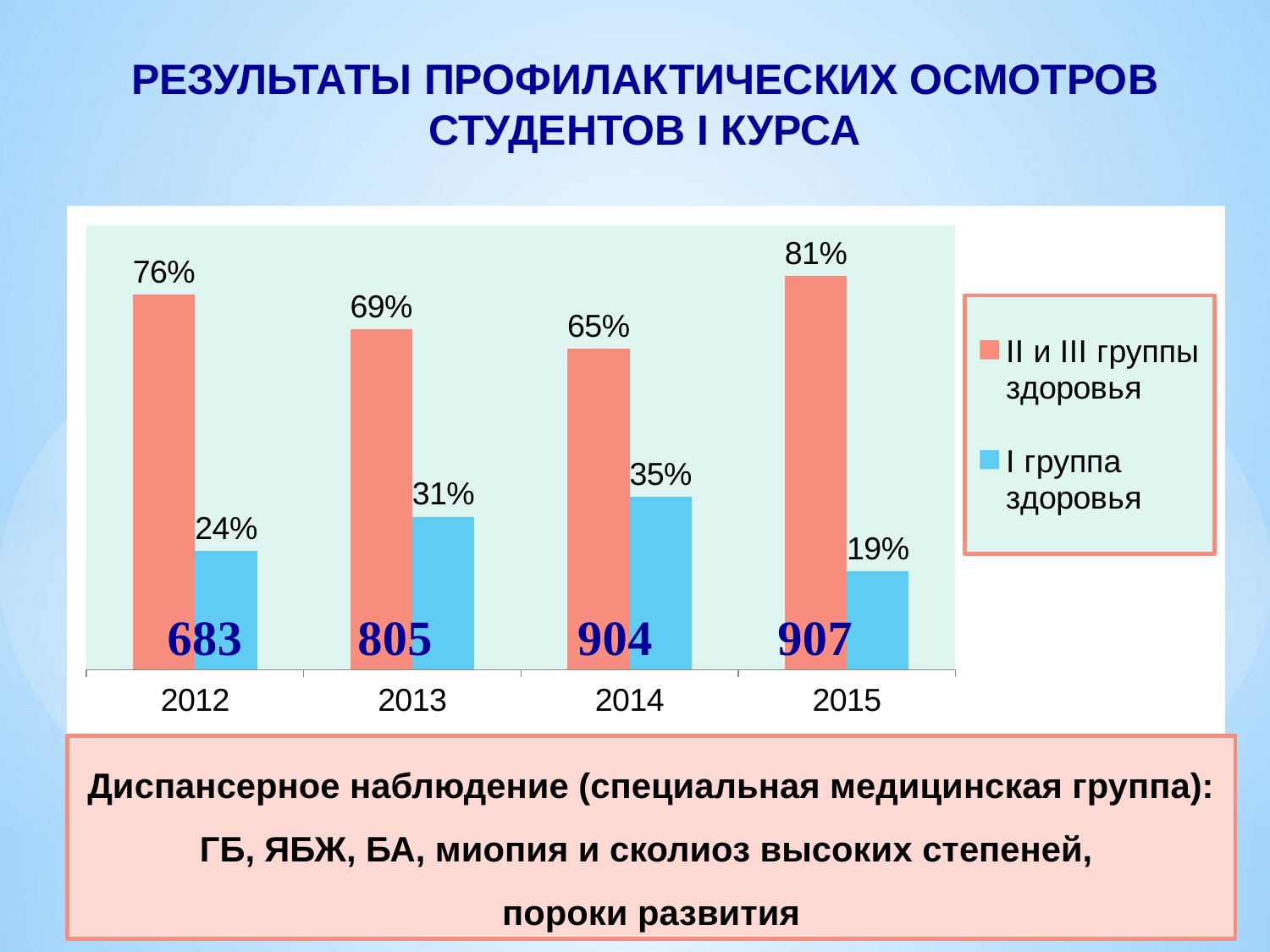
In which year is the value for 'I группа здоровья' lowest? 2015 What is the difference between the 'II и III группы здоровья' value and the 'I группа здоровья' value in 2013? 38% What is the value for 'II и III группы здоровья' in 2012? 76% How many years are shown on the x axis? 4 What is the value for 'I группа здоровья' in 2015? 19% What number is printed at the base of the bars for 2014? 904 What is the value for 'I группа здоровья' in 2014? 35% Which is larger: the 'I группа здоровья' value in 2013 or in 2014? 2014 How many series does the legend list? 2 What kind of chart is shown on the slide? bar chart In which year is the value for 'II и III группы здоровья' highest? 2015 Does the value for 'I группа здоровья' rise or fall from 2014 to 2015? fall